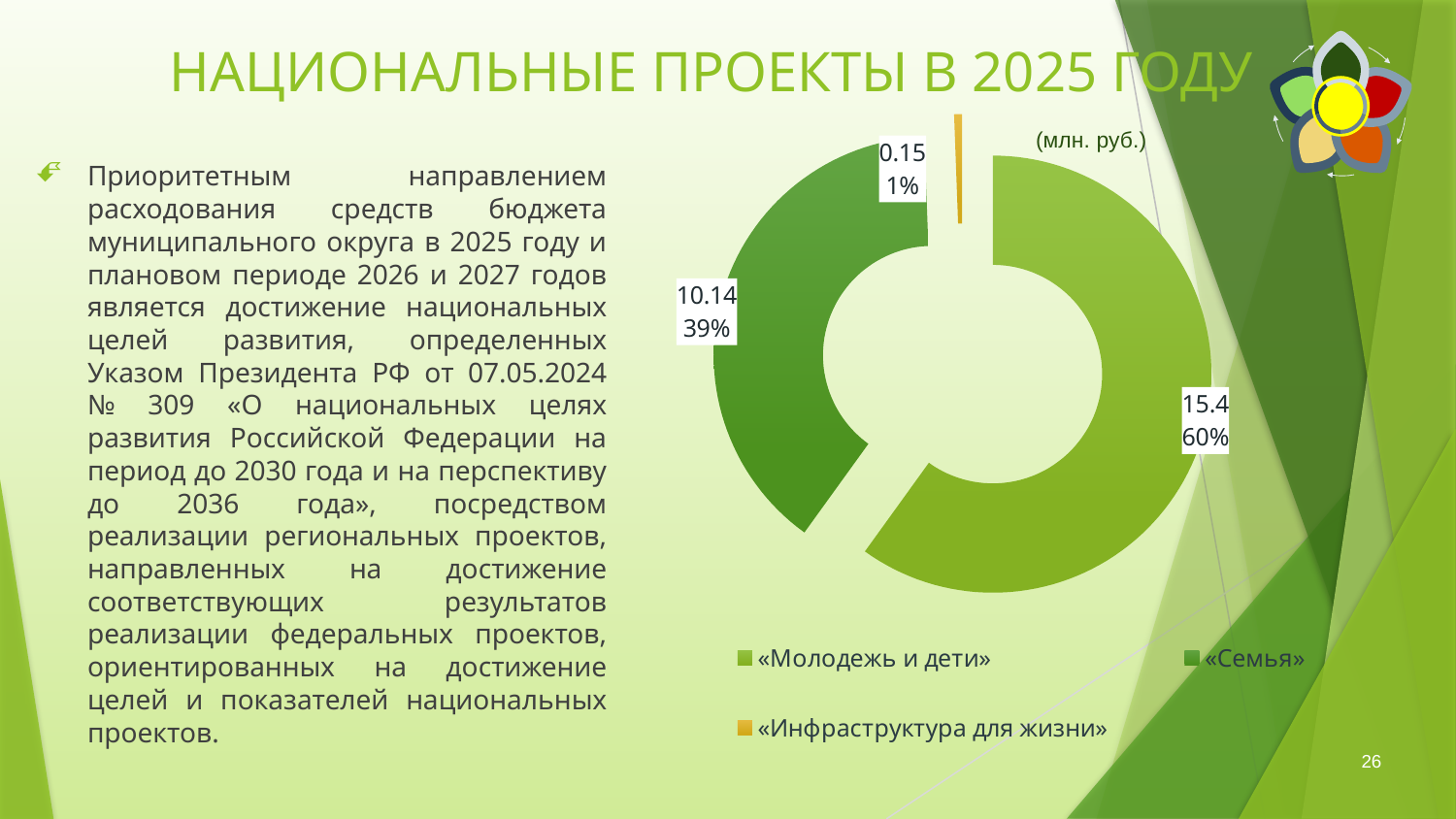
What is the value for «Инфраструктура для жизни» in the chart? 0.15 What is the value for «Молодежь и дети» in the chart? 15.4 What unit is indicated for the values in the chart? млн. руб. What kind of chart is shown on the slide? Doughnut (pie) chart Which category has the largest value in the chart? «Молодежь и дети» How many categories does the chart legend list? 3 Which category has the smallest value in the chart? «Инфраструктура для жизни» What share of the chart does «Инфраструктура для жизни» represent? 1% What is the value for «Семья» in the chart? 10.14 What is the difference between the values for «Молодежь и дети» and «Семья»? 5.26 What share of the chart does «Семья» represent? 39% What share of the chart does «Молодежь и дети» represent? 60%